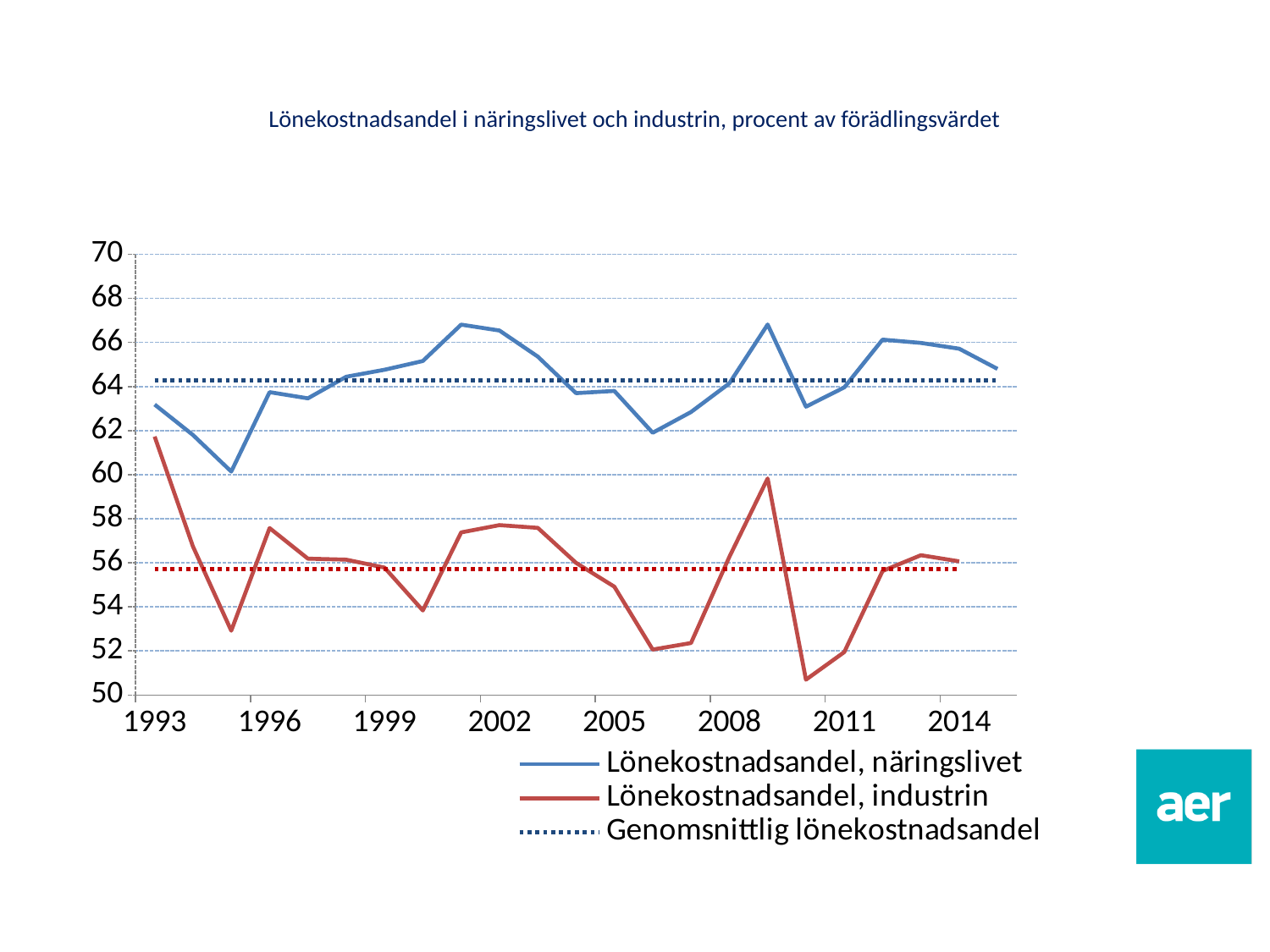
Is the value for Lönekostnadsandel, industrin in 2009 greater or less than 58? greater What is the title of the chart? Lönekostnadsandel i näringslivet och industrin, procent av förädlingsvärdet How many series does the legend list? 3 What colour is the line for Lönekostnadsandel, industrin? red What kind of chart is shown on the slide? line chart Is the value for Lönekostnadsandel, näringslivet in 2001 greater or less than 66? greater Is the value for Lönekostnadsandel, industrin in 1993 greater or less than 60? greater Which series has the higher value in 2009, Lönekostnadsandel, näringslivet or Lönekostnadsandel, industrin? Lönekostnadsandel, näringslivet In which year is Lönekostnadsandel, industrin at its lowest? 2010 In which year is Lönekostnadsandel, näringslivet at its lowest? 1995